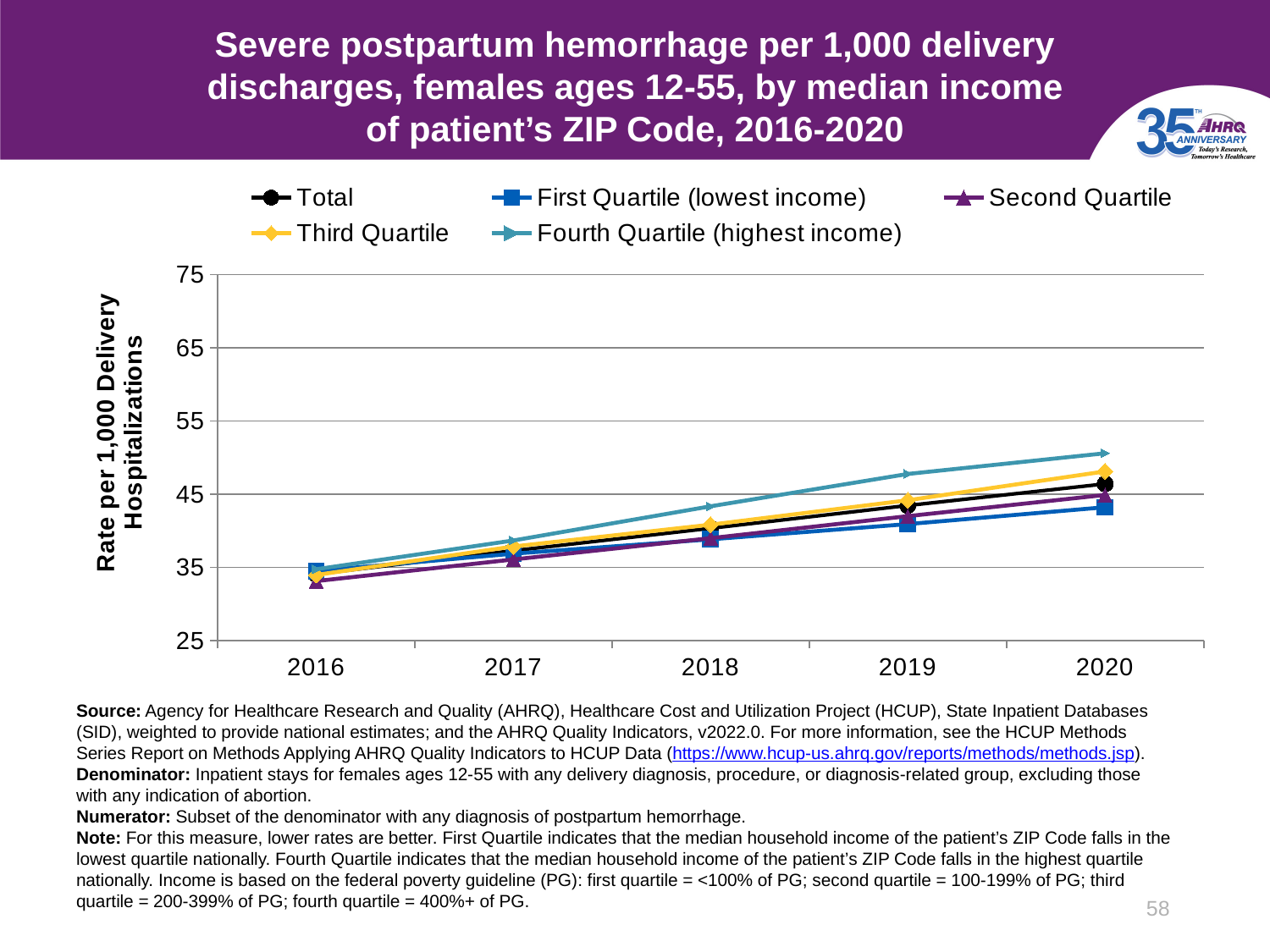
Which series has the highest value in 2020? Fourth Quartile (highest income) Which series has the highest value in 2019? Fourth Quartile (highest income) What kind of chart is shown on the slide? Line chart How many years are plotted along the x axis? 5 Do the rates for the Total series rise or fall from 2016 to 2020? Rise In 2020, which is larger: the value for Fourth Quartile (highest income) or the value for First Quartile (lowest income)? Fourth Quartile (highest income) Is the value for Third Quartile in 2020 greater or less than 45? greater How many series does the legend list? 5 Is the value for Total in 2018 greater or less than 45? less What is the label of the y axis? Rate per 1,000 Delivery Hospitalizations Is the value for Fourth Quartile (highest income) in 2020 greater or less than 45? greater